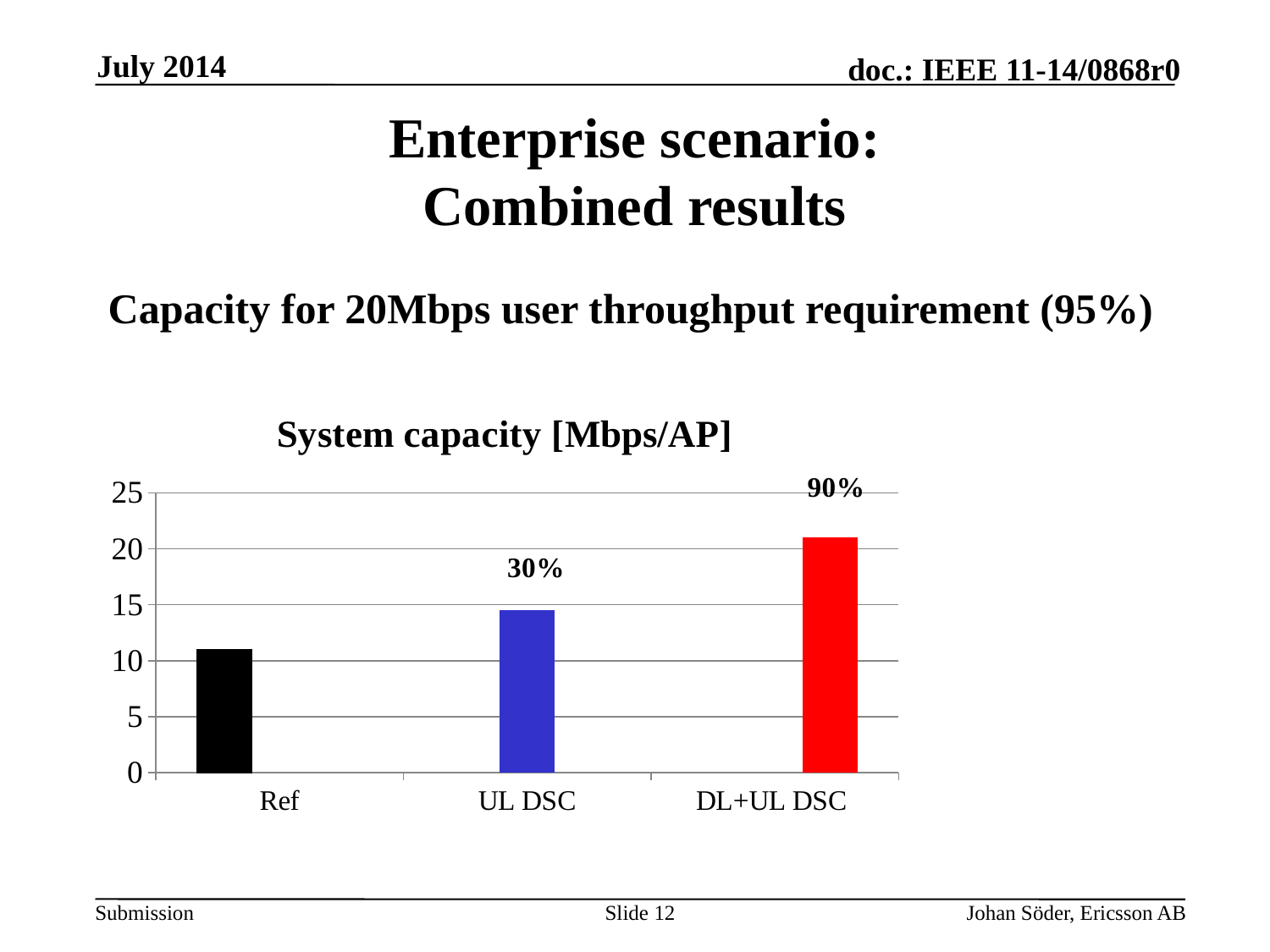
Which category has the lowest system capacity? Ref Is the value for Ref greater or less than 15? less What percentage label is printed above the UL DSC bar? 30% Which has a larger system capacity, Ref or UL DSC? UL DSC Which category has the highest system capacity? DL+UL DSC Do the values rise or fall from Ref to DL+UL DSC along the x axis? rise Is the value for DL+UL DSC greater or less than 20? greater How many categories are shown on the x axis of the chart? 3 Is the value for UL DSC greater or less than 10? greater What type of chart is shown on the slide? bar chart What is the title of the chart? System capacity [Mbps/AP] What percentage label is printed above the DL+UL DSC bar? 90%